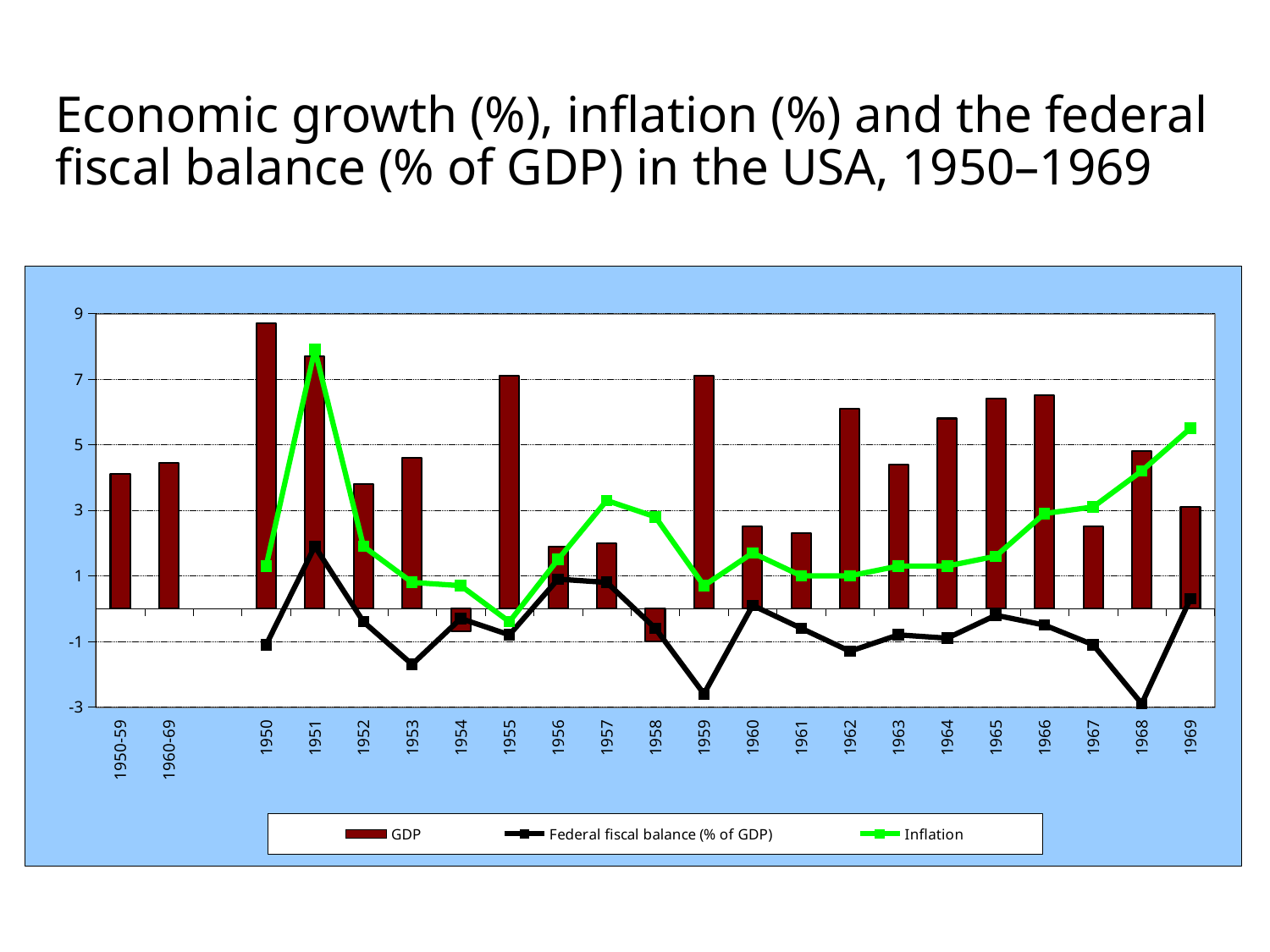
In which year does the Inflation line reach its highest point? 1951 How many series does the legend list? 3 Which year has the highest GDP bar? 1950 How many categories are shown along the x axis? 22 In which year does the Federal fiscal balance line reach its highest point? 1951 Does the Inflation line rise or fall from 1965 to 1969? rise In which year does the Inflation line reach its lowest point? 1955 Is the Federal fiscal balance value for 1953 greater or less than -1? less What kind of chart is shown on the slide? A combined bar and line chart Is the GDP value for 1950 greater or less than 7? greater Which is larger, the GDP value for 1955 or for 1956? 1955 Is the Inflation value for 1969 greater or less than 5? greater